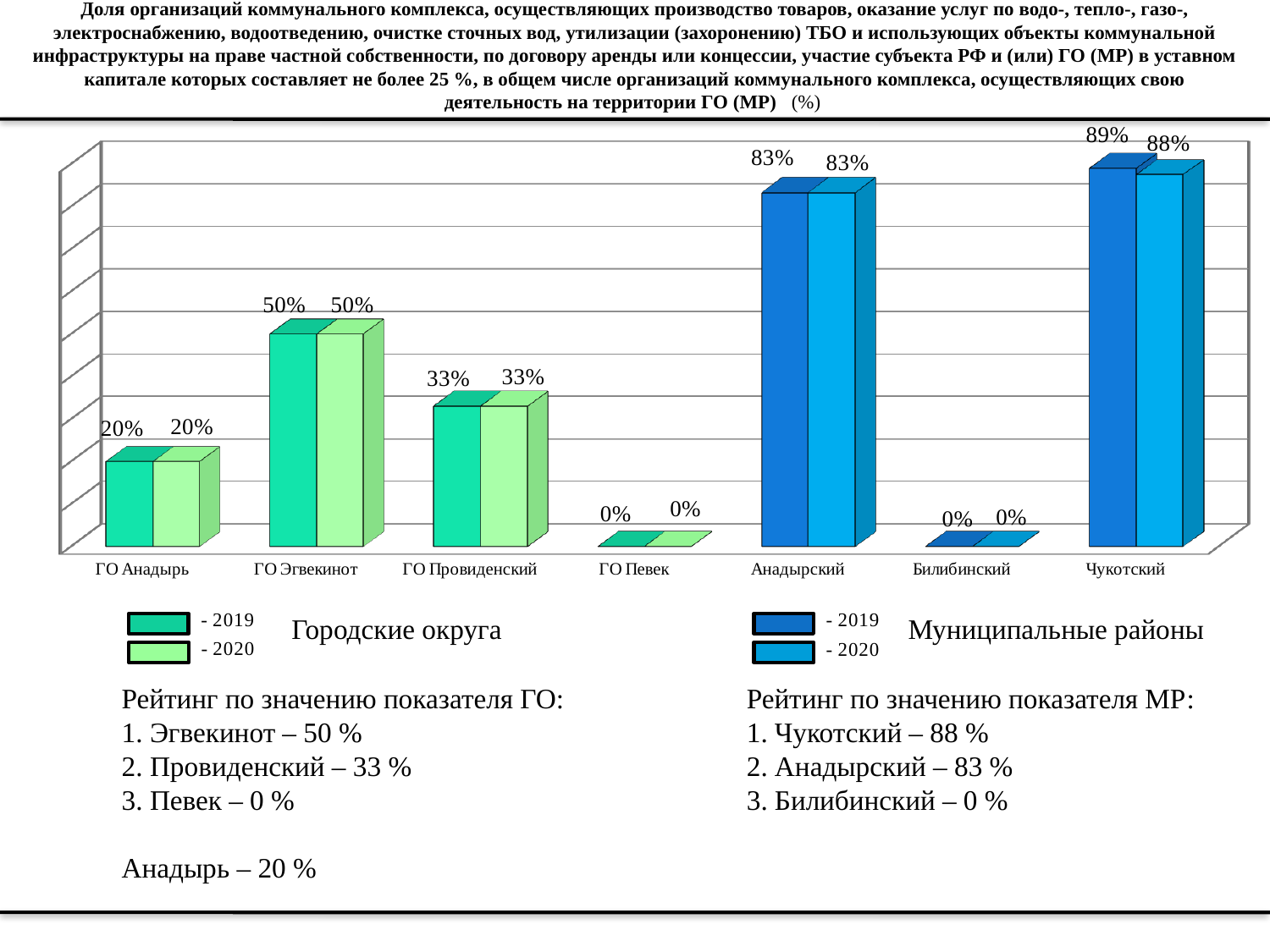
Which is larger, the 2020 value for ГО Эгвекинот or the 2020 value for ГО Провиденский? ГО Эгвекинот Which categories have a value of 0% in 2020? ГО Певек and Билибинский Did the value for Чукотский rise or fall from 2019 to 2020? Fall What is the difference between the 2019 values for Чукотский and Анадырский? 6% What is the 2019 value for ГО Провиденский? 33% What is the 2019 value for Чукотский? 89% How many categories are shown on the x axis of the chart? 7 How many series does the legend list for Городские округа? 2 What type of chart is shown on the slide? Bar chart What is the 2020 value for ГО Эгвекинот? 50% Which category has the highest 2019 value? Чукотский What is the 2020 value for Чукотский? 88%